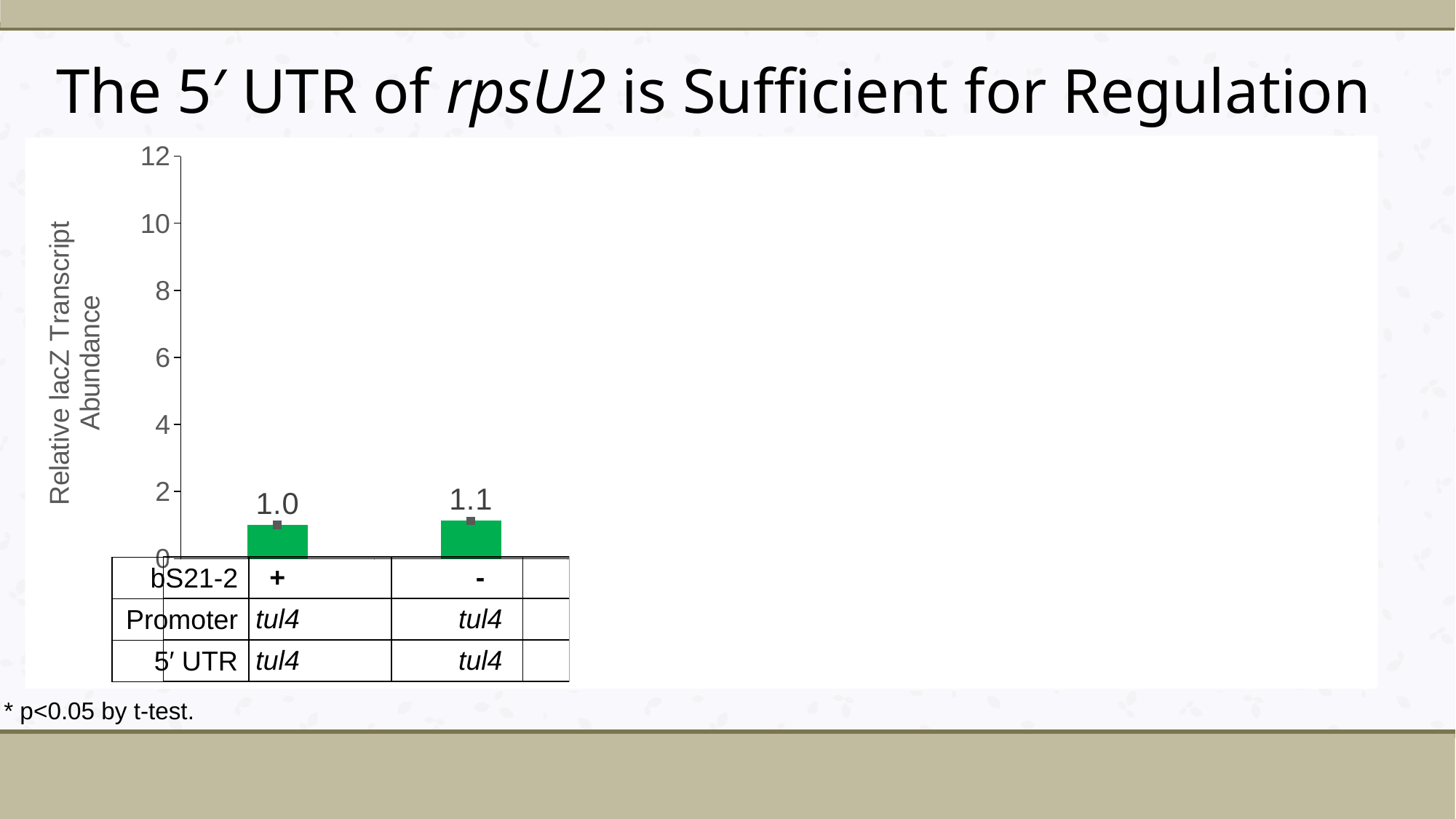
Is the value for the bS21-2 + condition greater or less than 4? less What is the relative lacZ transcript abundance for the bS21-2 - condition? 1.1 What is the relative lacZ transcript abundance for the bS21-2 + condition? 1.0 What is the difference in relative lacZ transcript abundance between the bS21-2 - and bS21-2 + conditions? 0.1 Is the value for the bS21-2 - condition greater or less than 2? less What is the maximum value shown on the y axis? 12 Which promoter is used for both conditions in the chart? tul4 Which condition has the lower relative lacZ transcript abundance? bS21-2 + How many bars are plotted in the chart? 2 What is the label of the y axis? Relative lacZ Transcript Abundance What kind of chart is shown on the slide? bar chart Which condition has the higher relative lacZ transcript abundance, bS21-2 + or bS21-2 -? bS21-2 -